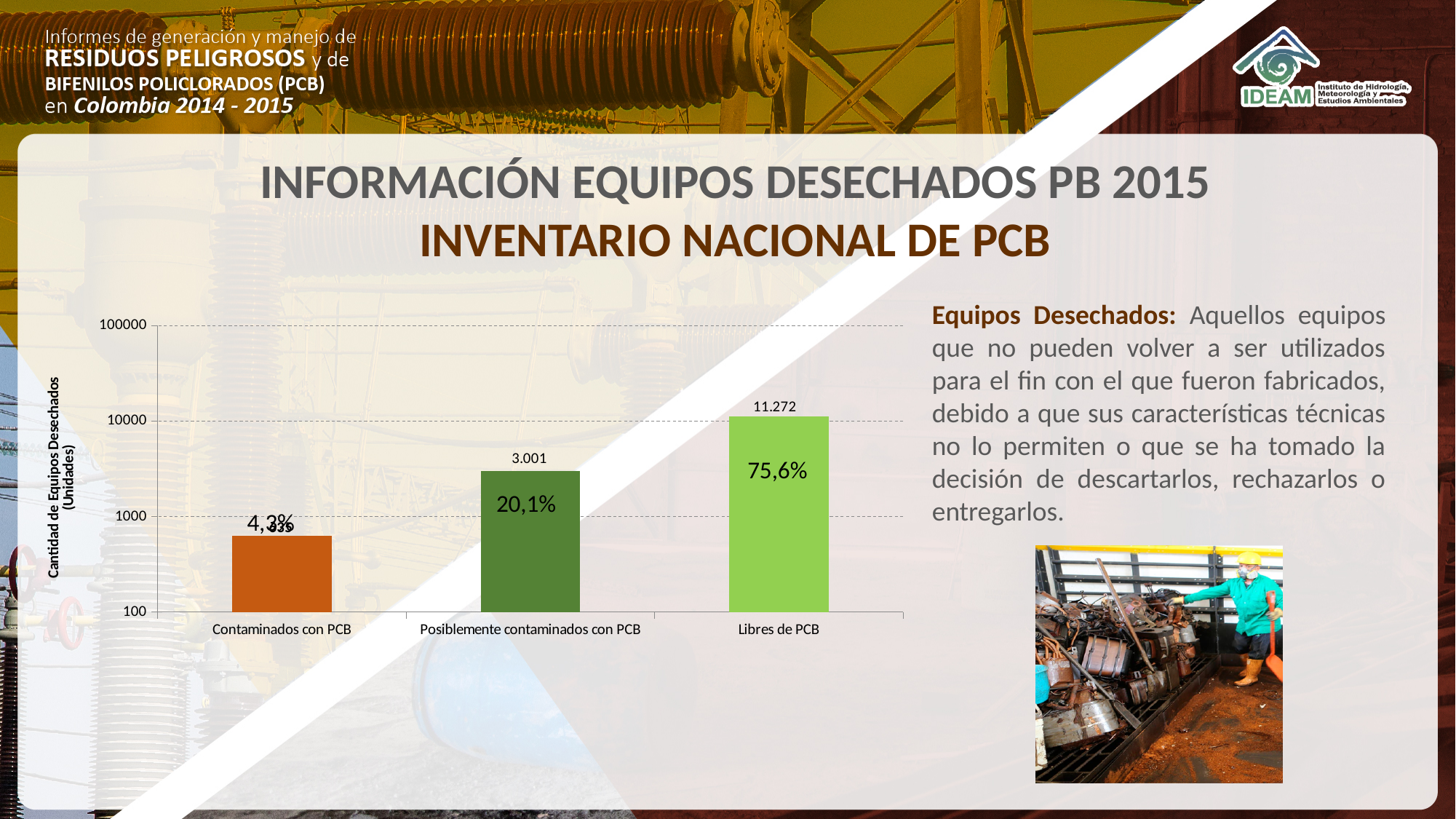
How many categories are shown on the x axis? 3 Which category has the highest value? Libres de PCB What is the value for Libres de PCB? 11.272 What percentage is shown on the Contaminados con PCB bar? 4,3% What is the value for Posiblemente contaminados con PCB? 3.001 What percentage is shown on the Libres de PCB bar? 75,6% What kind of chart is shown on the slide? bar chart Which is larger, the value for Posiblemente contaminados con PCB or the value for Contaminados con PCB? Posiblemente contaminados con PCB What is the difference between the values for Libres de PCB and Posiblemente contaminados con PCB? 8.271 Is the value for Contaminados con PCB greater or less than 1000? less What percentage is shown on the Posiblemente contaminados con PCB bar? 20,1% Which category has the lowest value? Contaminados con PCB